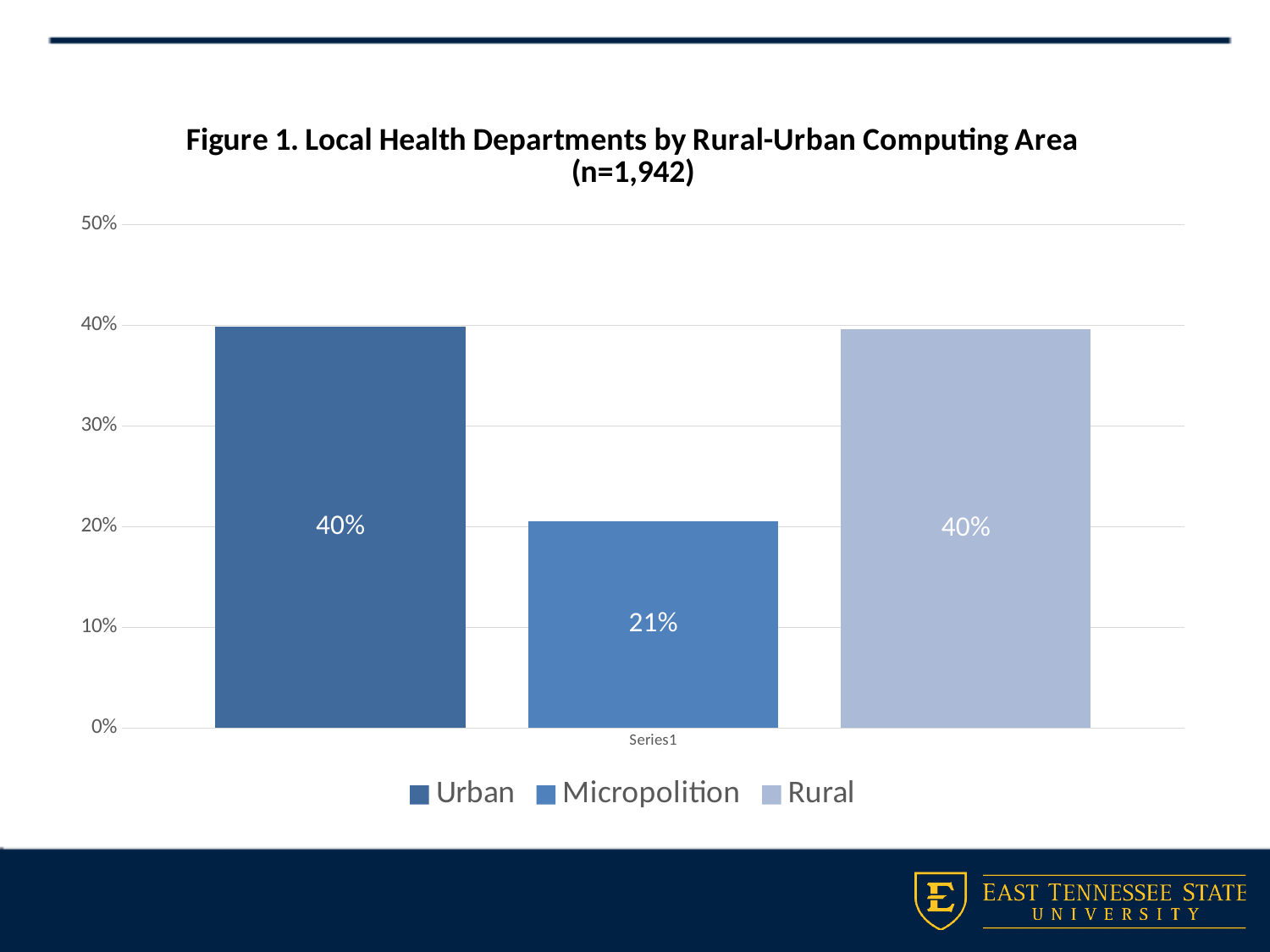
Which series has the lowest value? Micropolition Which is larger, the value for Rural or the value for Micropolition? Rural What kind of chart is shown on the slide? bar chart Is the value for Micropolition greater or less than 30%? less What is the value for Urban? 40% What is the value for Rural? 40% How many series does the legend list? 3 What is the highest value shown on the vertical axis? 50% What is the difference between the Urban and Micropolition values? 19% What is the value for Micropolition? 21% Is the value for Urban greater or less than 30%? greater What is the title of the chart? Figure 1. Local Health Departments by Rural-Urban Computing Area (n=1,942)